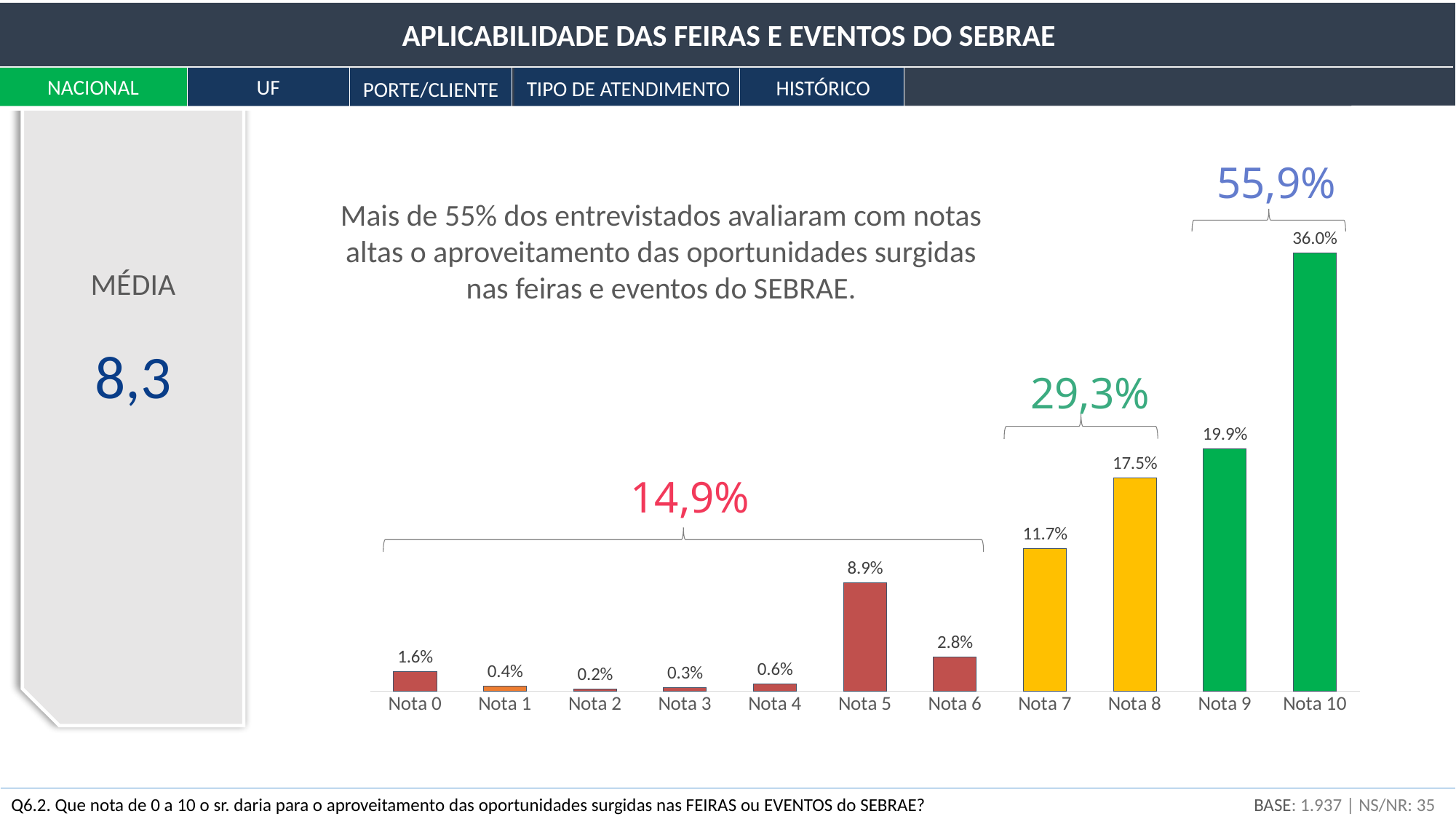
Do the values generally rise or fall from Nota 6 to Nota 10? Rise What combined percentage is shown above the bracket covering Nota 9 and Nota 10? 55,9% What is the difference between the values for Nota 10 and Nota 9? 16.1% How many categories are shown on the x axis? 11 What kind of chart is shown on the slide? Bar chart What is the value for Nota 8? 17.5% Which is larger, the value for Nota 7 or the value for Nota 6? Nota 7 Which category has the lowest value? Nota 2 Which category has the highest value? Nota 10 What is the value for Nota 10? 36.0% What is the MÉDIA (average) value shown on the left of the slide? 8,3 What is the value for Nota 5? 8.9%